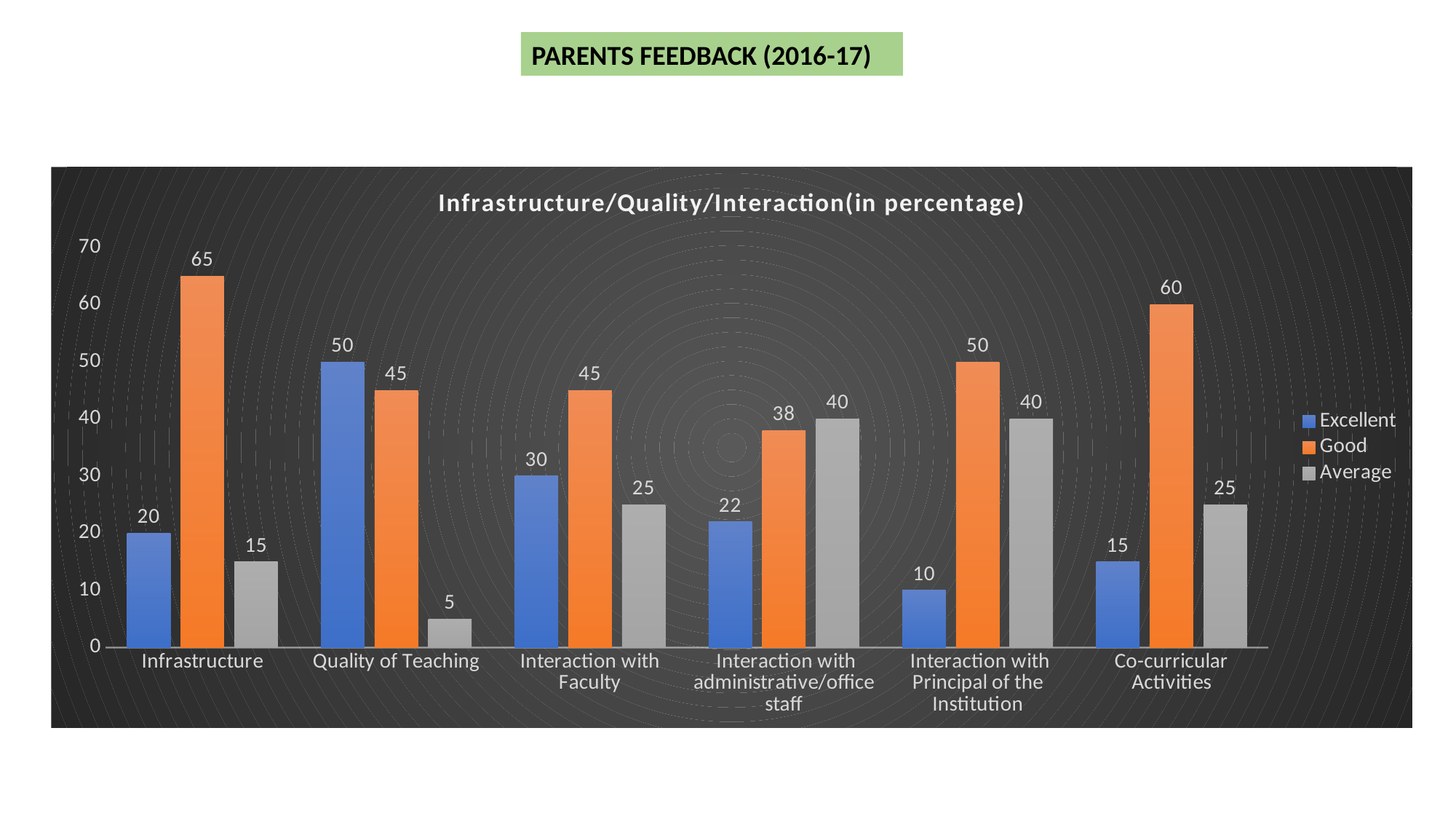
What is the Excellent value for Interaction with Principal of the Institution? 10 What is the Good value for Infrastructure? 65 Which category has the highest Good value? Infrastructure What is the title of the chart? Infrastructure/Quality/Interaction(in percentage) What is the difference between the Good and Excellent values for Co-curricular Activities? 45 Which is larger for Interaction with Faculty: the Excellent value or the Average value? Excellent How many series does the legend list? 3 Which category has the lowest Average value? Quality of Teaching What is the Excellent value for Quality of Teaching? 50 How many categories are shown on the x axis? 6 What kind of chart is shown on the slide? Bar chart What is the Average value for Interaction with administrative/office staff? 40